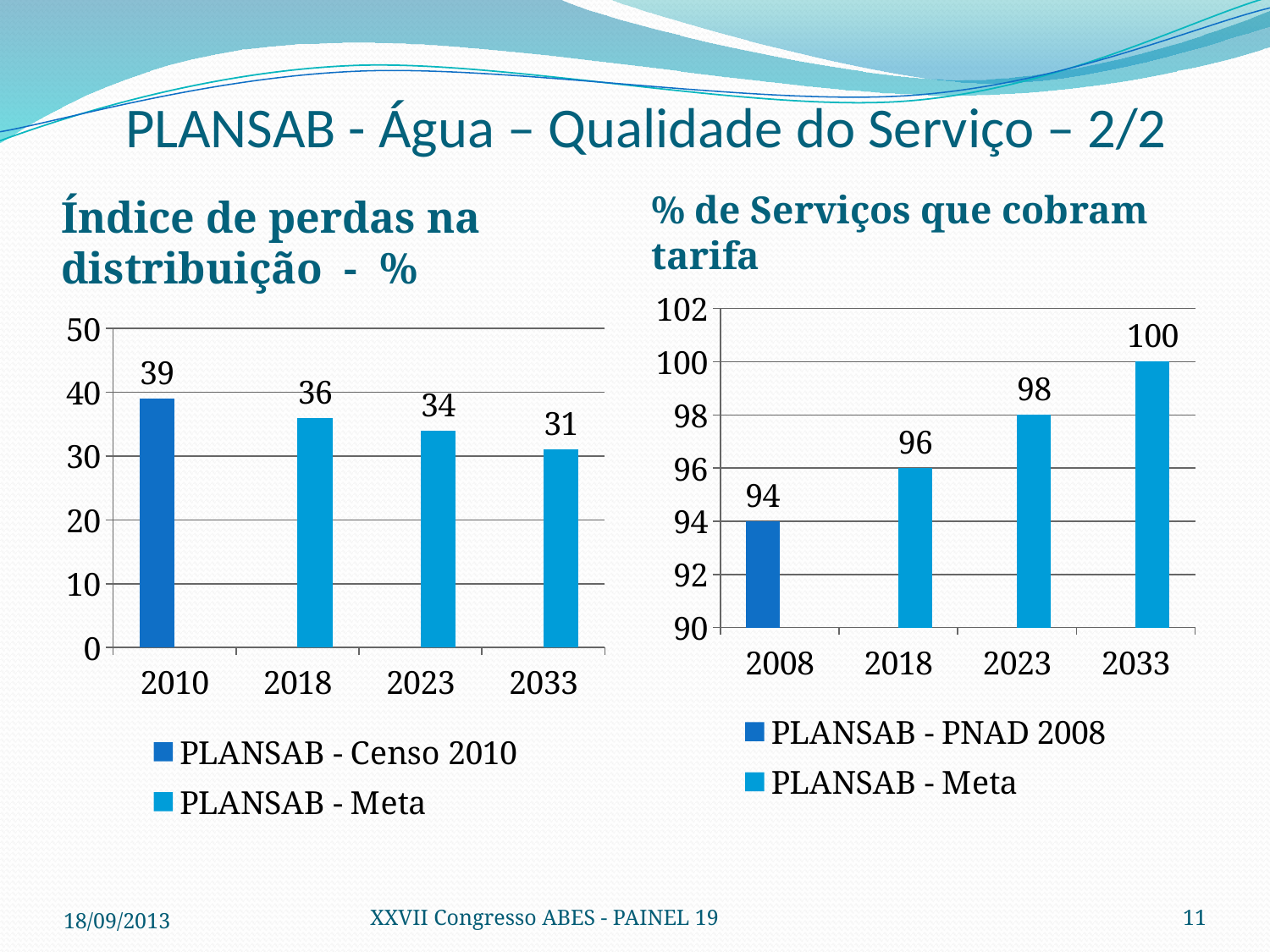
In the left chart 'Índice de perdas na distribuição - %', what is the difference between the 2010 and 2033 values? 8 In the left chart 'Índice de perdas na distribuição - %', which year has the lowest value? 2033 In the left chart 'Índice de perdas na distribuição - %', how many series does the legend list? 2 What kind of chart is the right chart '% de Serviços que cobram tarifa'? bar chart In the right chart '% de Serviços que cobram tarifa', which year has the highest value? 2033 In the right chart '% de Serviços que cobram tarifa', which series does the legend list first? PLANSAB - PNAD 2008 In the left chart 'Índice de perdas na distribuição - %', what is the value for 2033? 31 In the right chart '% de Serviços que cobram tarifa', what is the value for 2018? 96 In the right chart '% de Serviços que cobram tarifa', how many years are shown on the x axis? 4 In the left chart 'Índice de perdas na distribuição - %', do the values rise or fall from 2010 to 2033? fall In the left chart 'Índice de perdas na distribuição - %', what is the value for 2010? 39 In the right chart '% de Serviços que cobram tarifa', what is the difference between the 2033 and 2008 values? 6